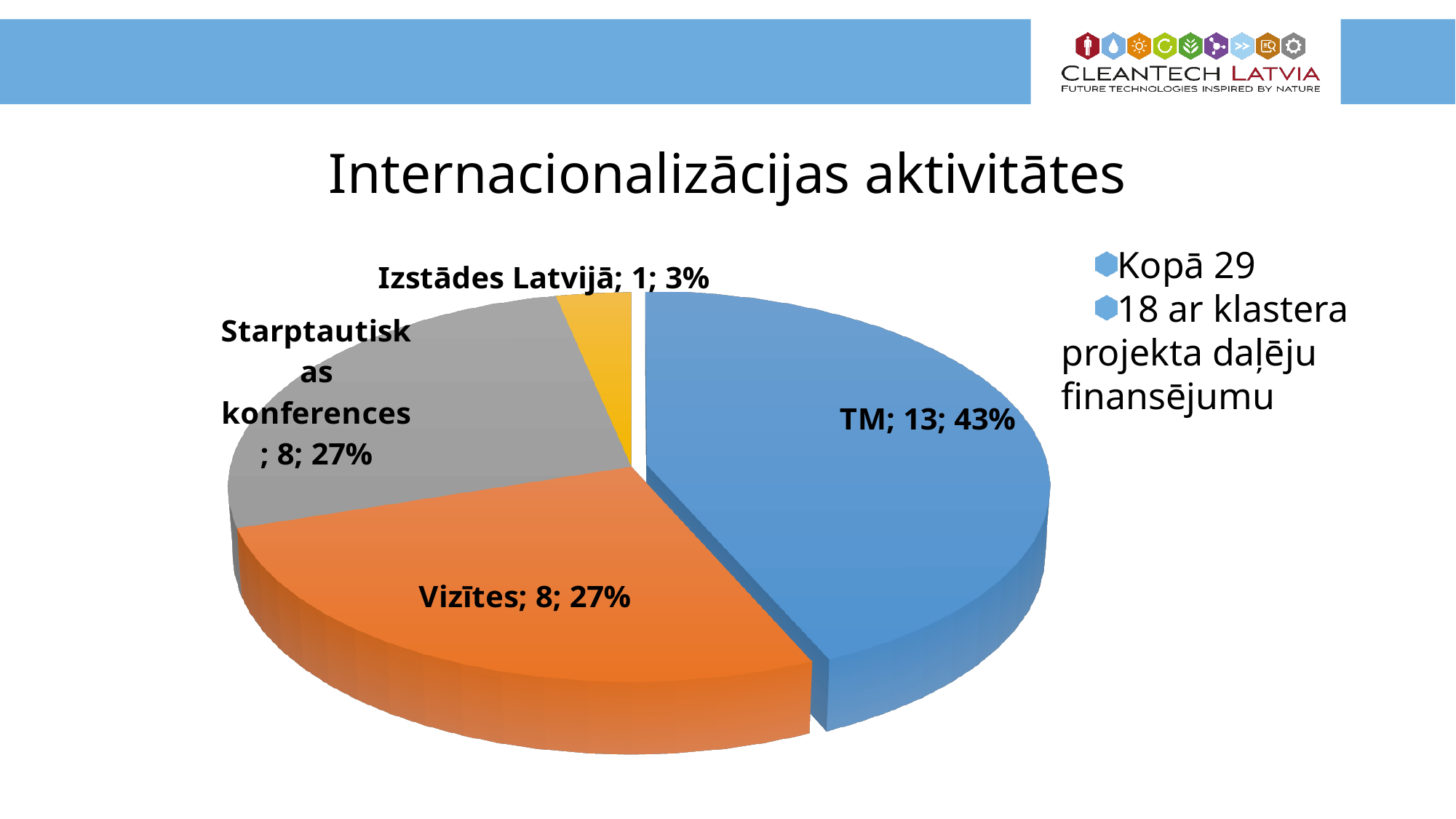
Which category has the largest slice? TM What kind of chart is shown on the slide? pie chart What percentage share does the TM slice have? 43% What is the value for TM in the pie chart? 13 Which category has the smallest slice? Izstādes Latvijā What is the total of all slice values in the pie chart? 29 What is the value for Vizītes? 8 How many slices does the pie chart have? 4 Which is larger, the value for TM or the value for Starptautiskas konferences? TM What colour is the Vizītes slice? orange What is the difference between the values for TM and Vizītes? 5 What percentage share does the Izstādes Latvijā slice have? 3%